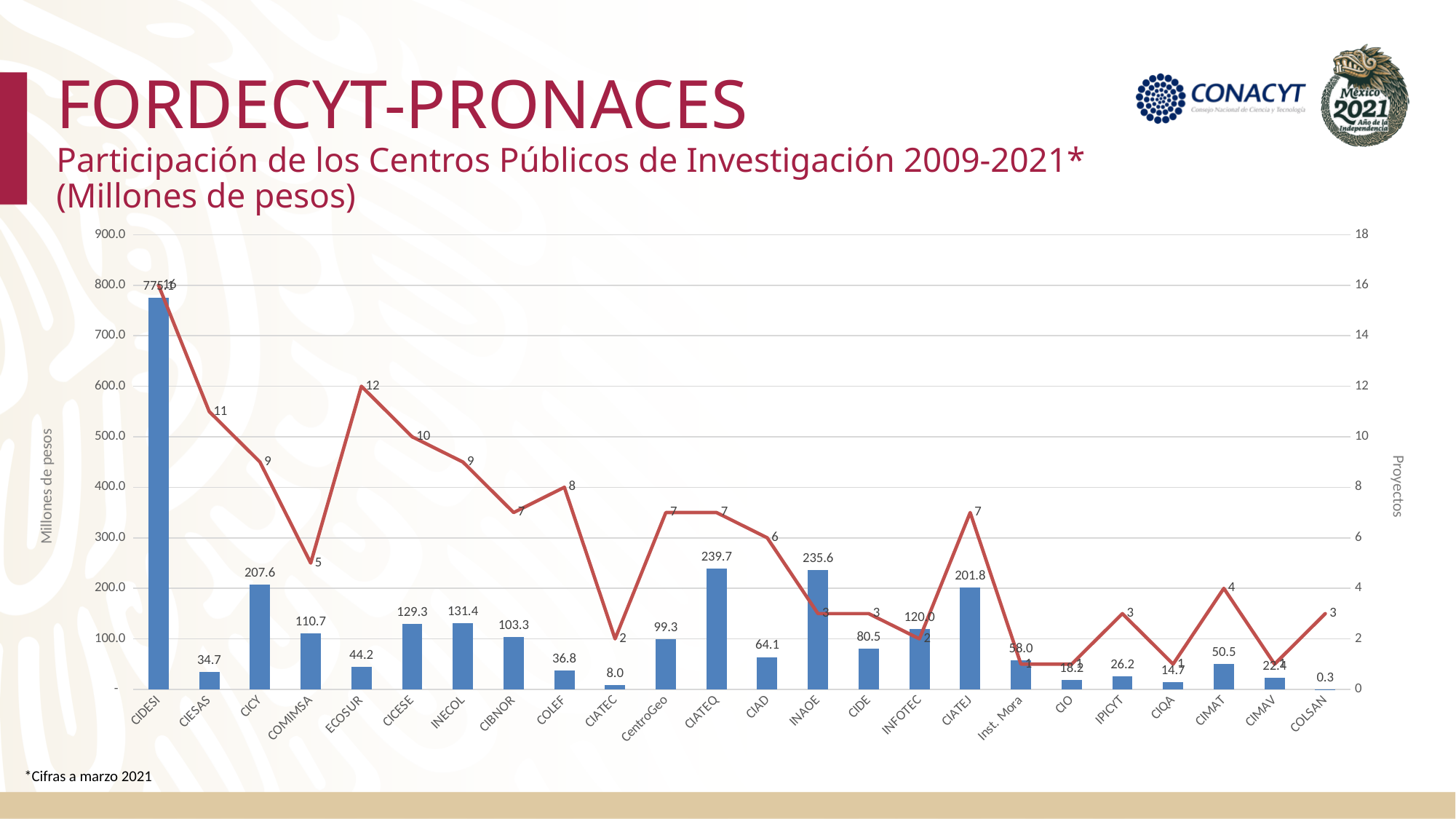
What is the label of the left vertical axis? Millones de pesos What is the value in millions of pesos for CIATEQ? 239.7 Is the value in millions of pesos for CIDESI greater or less than 700.0? greater How many projects (Proyectos) does the line show for CIATEJ? 7 What is the value in millions of pesos for CICY? 207.6 What is the difference in millions of pesos between CIATEQ and INAOE? 4.1 Which has a larger value in millions of pesos, INECOL or CICESE? INECOL How many projects (Proyectos) does the line show for ECOSUR? 12 Which center has the highest value in millions of pesos? CIDESI Which center has the lowest value in millions of pesos? COLSAN What kind of chart is this? Combined bar and line chart How many centers are shown on the x axis? 24